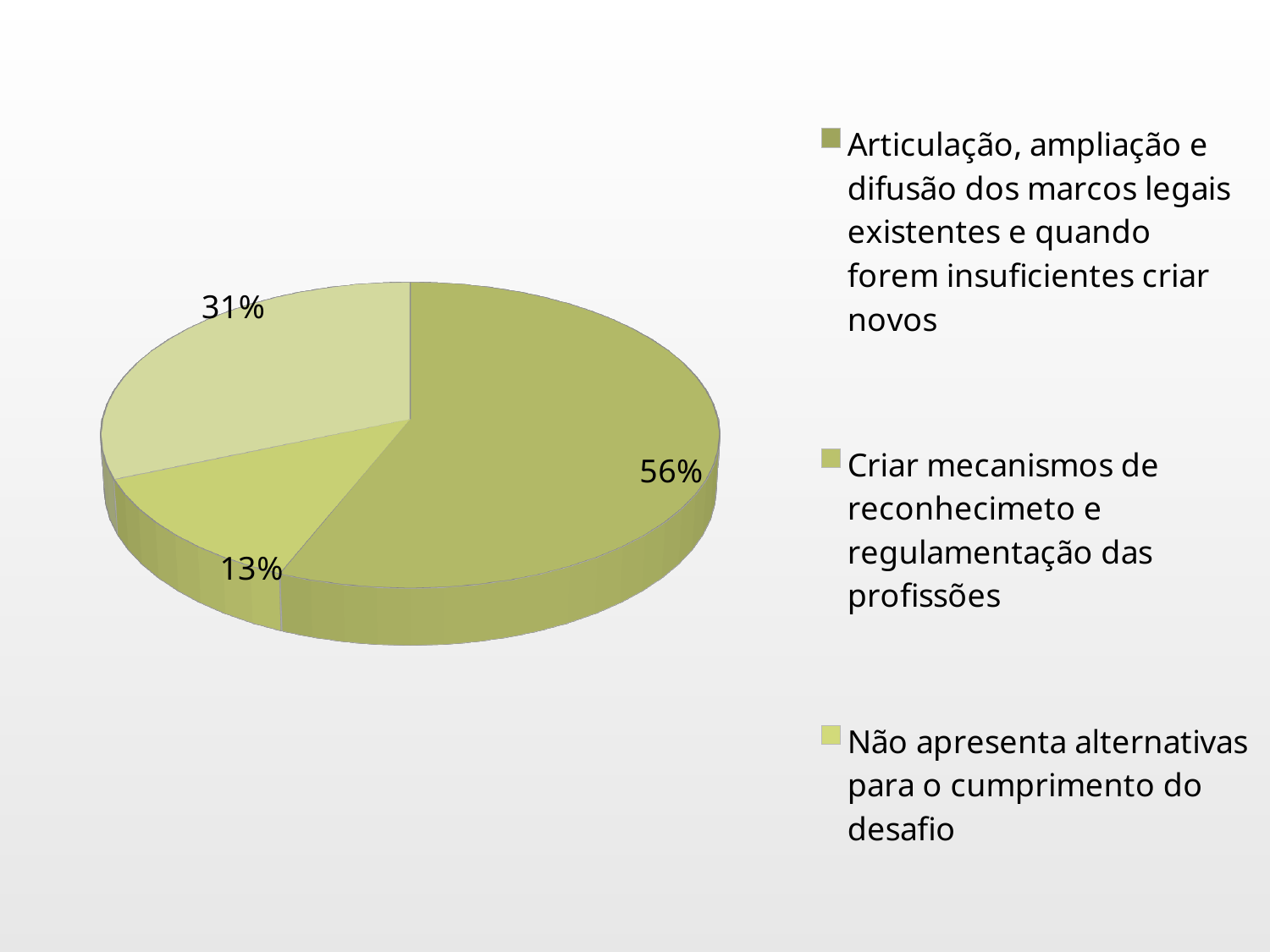
What share of the pie does "Articulação, ampliação e difusão dos marcos legais existentes e quando forem insuficientes criar novos" represent? 56% What is the difference in percentage points between the largest slice and the smallest slice? 43 Which is larger: the slice for "Não apresenta alternativas para o cumprimento do desafio" or the slice for "Criar mecanismos de reconhecimeto e regulamentação das profissões"? Não apresenta alternativas para o cumprimento do desafio Which category has the smallest slice of the pie? Criar mecanismos de reconhecimeto e regulamentação das profissões What share of the pie does "Criar mecanismos de reconhecimeto e regulamentação das profissões" represent? 13% What is the difference in percentage points between "Não apresenta alternativas para o cumprimento do desafio" and "Criar mecanismos de reconhecimeto e regulamentação das profissões"? 18 How many slices does the pie chart have? 3 Which category has the largest slice of the pie? Articulação, ampliação e difusão dos marcos legais existentes e quando forem insuficientes criar novos How many entries does the legend list? 3 What kind of chart is shown on the slide? pie chart What share of the pie does "Não apresenta alternativas para o cumprimento do desafio" represent? 31% Is the pie chart drawn in 3D? yes